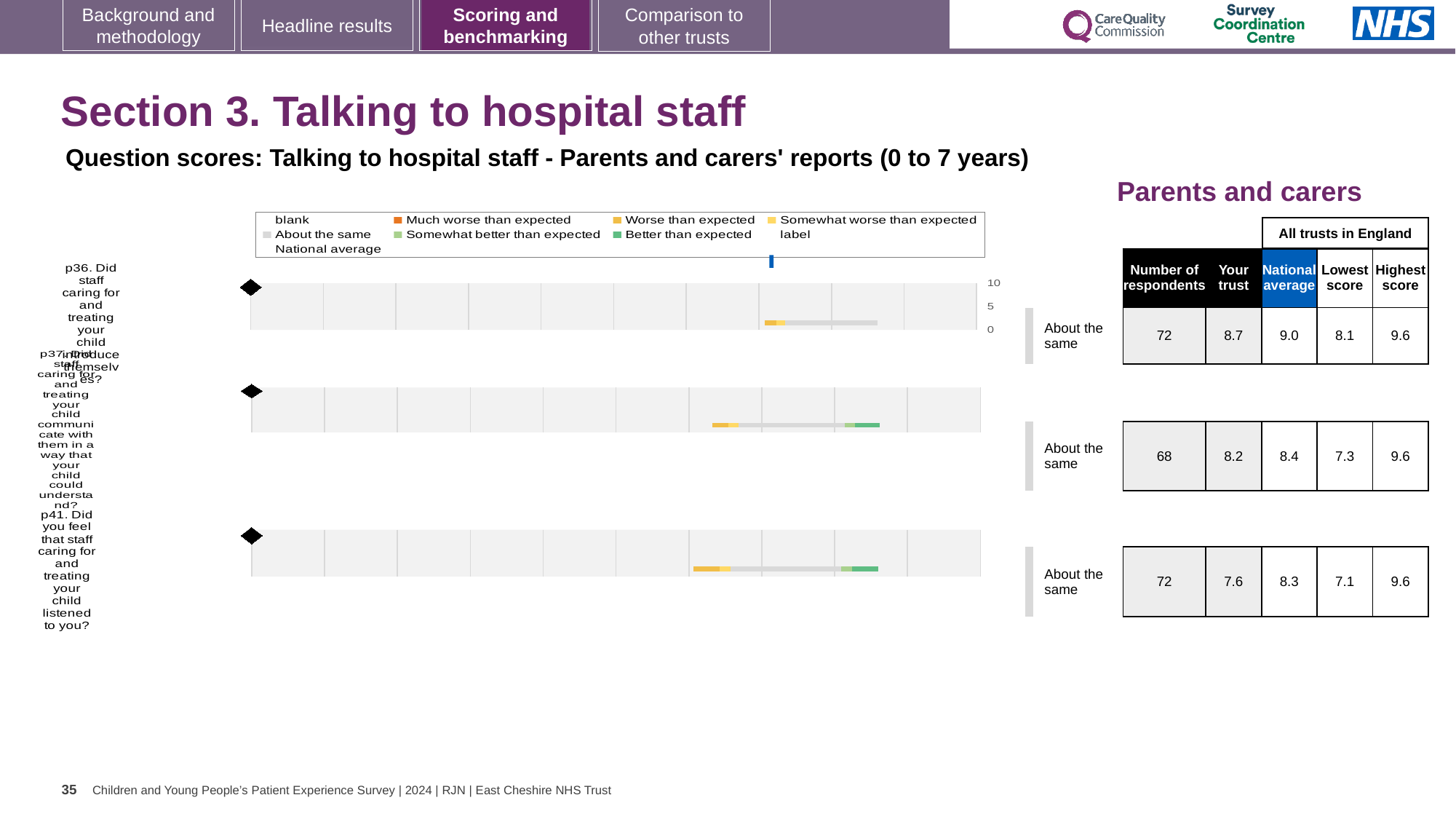
What benchmark label is shown for all three questions on this slide? About the same What is the national average score for p41 (Did you feel that staff caring for and treating your child listened to you)? 8.3 What is the 'Your trust' score for p36 (Did staff caring for and treating your child introduce themselves)? 8.7 How many respondents are listed for p37 (Did staff communicate with them in a way that your child could understand)? 68 Which question has the highest 'Your trust' score? p36 What is the lowest score across all trusts in England for p37? 7.3 Which question has the lowest 'Your trust' score? p41 Which has the larger 'Your trust' score, p36 or p37? p36 How many questions (categories) are plotted in the chart? 3 What kind of chart is used to show the question scores on this slide? Bar chart For p41, how much higher is the national average than the 'Your trust' score? 0.7 What is the highest score across all trusts in England for p36? 9.6